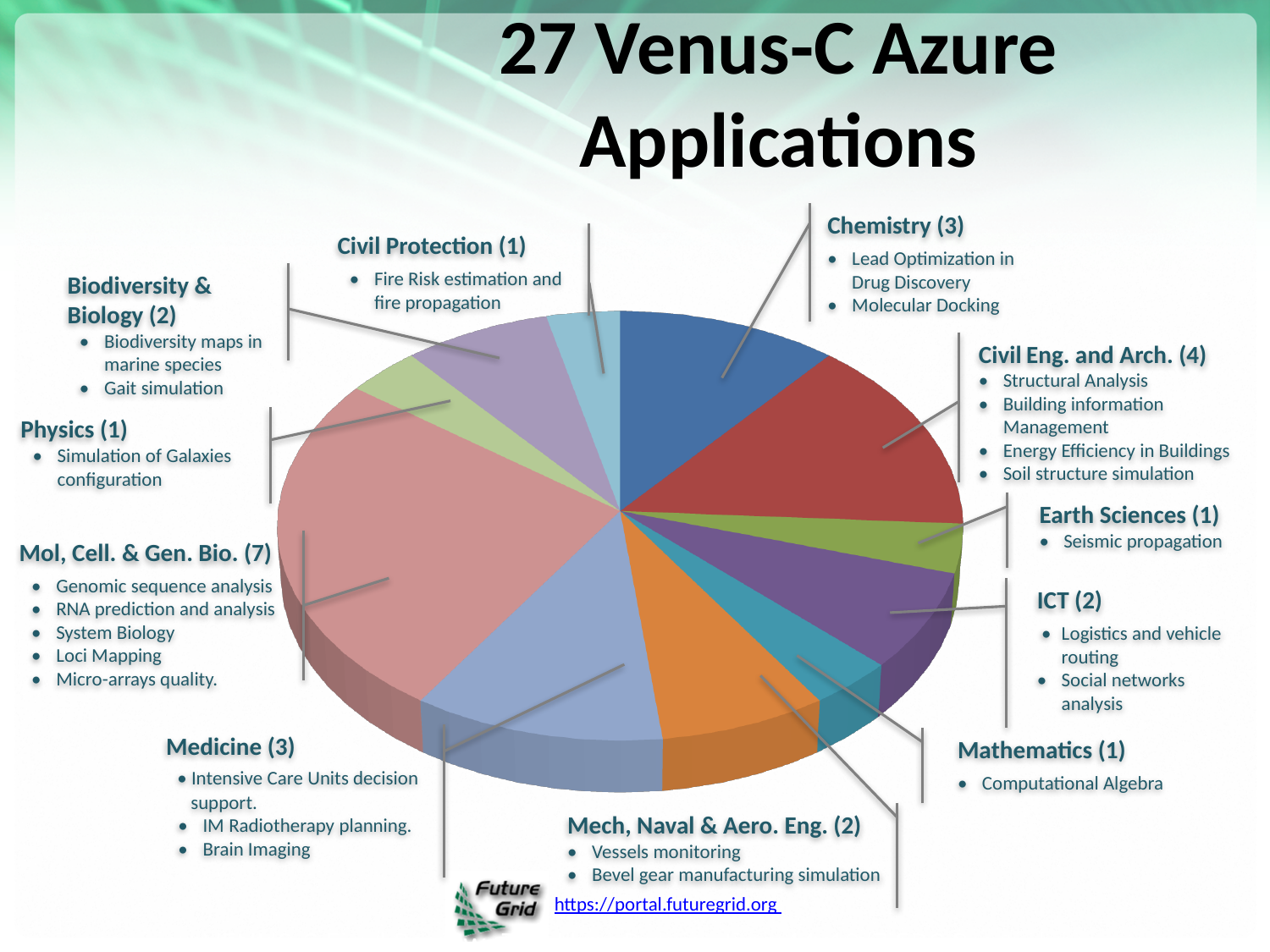
What is the title of the chart on the slide? 27 Venus-C Azure Applications How many applications are in the Civil Eng. and Arch. category? 4 How many applications are in the Mol, Cell. & Gen. Bio. category? 7 What kind of chart is shown on the slide? pie chart How many applications are in the Chemistry category? 3 What is the total number of applications across all categories in the pie chart? 27 How many applications are in the ICT category? 2 Which category has the largest number of applications? Mol, Cell. & Gen. Bio. Which has more applications, Medicine or Mathematics? Medicine What is the difference between the number of applications in Civil Eng. and Arch. and in Earth Sciences? 3 What is the difference between the number of applications in Mol, Cell. & Gen. Bio. and in Civil Eng. and Arch.? 3 How many application categories (slices) does the pie chart show? 11